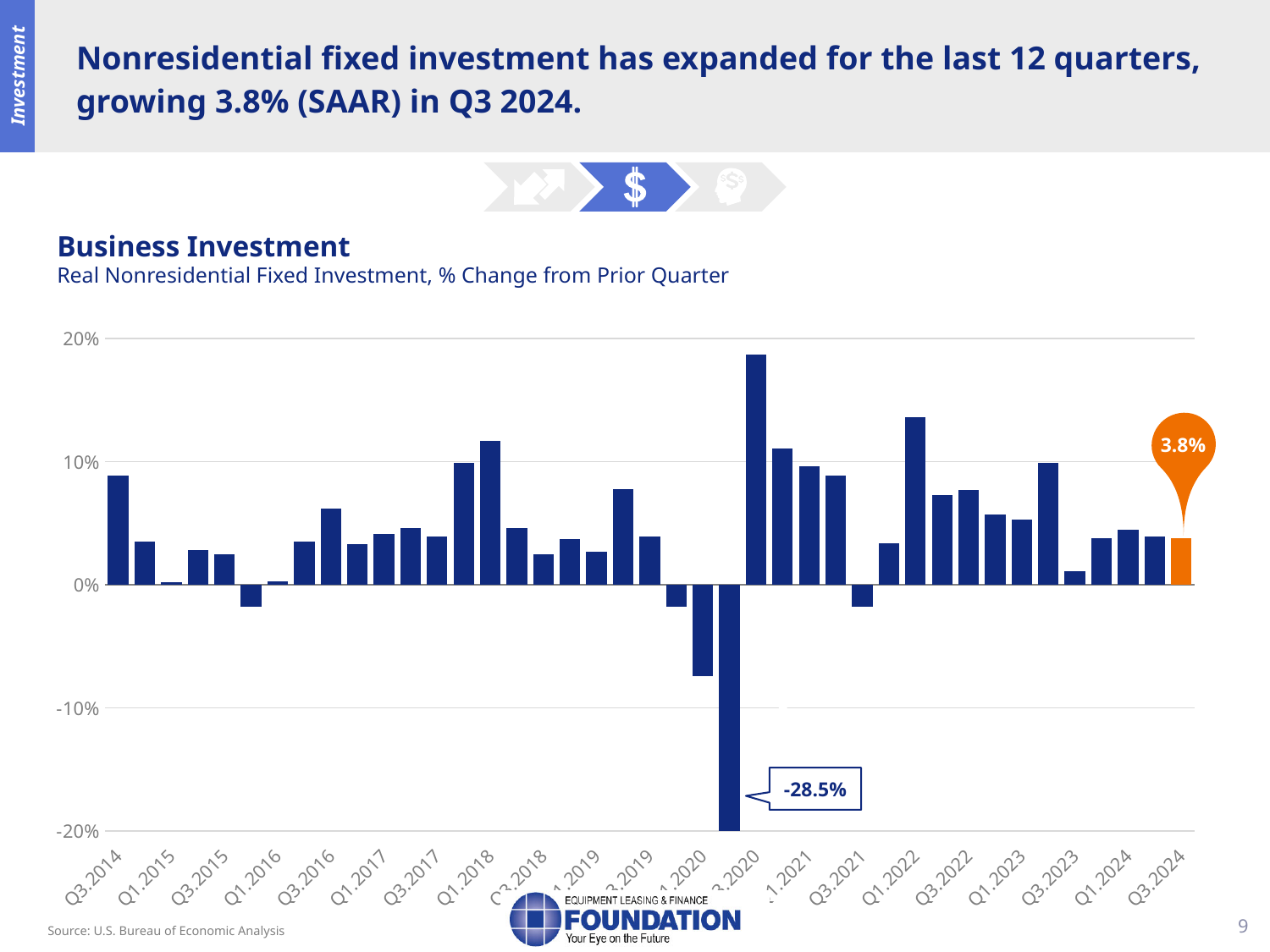
Is the value for Q3 2021 greater or less than 0%? less What kind of chart is shown on the slide? bar chart What is the title of the chart? Business Investment Is the value for Q3 2023 greater or less than 5%? less What is the lowest value shown in the Business Investment chart? -28.5% Which is larger, the value for Q3 2014 or the value for Q3 2024? Q3 2014 Is the value for Q3 2014 greater or less than 5%? greater Which is larger, the value for Q1 2022 or the value for Q3 2022? Q1 2022 What colour is the bar for Q3 2024? orange What is the value for Q3 2024 in the Business Investment chart? 3.8%